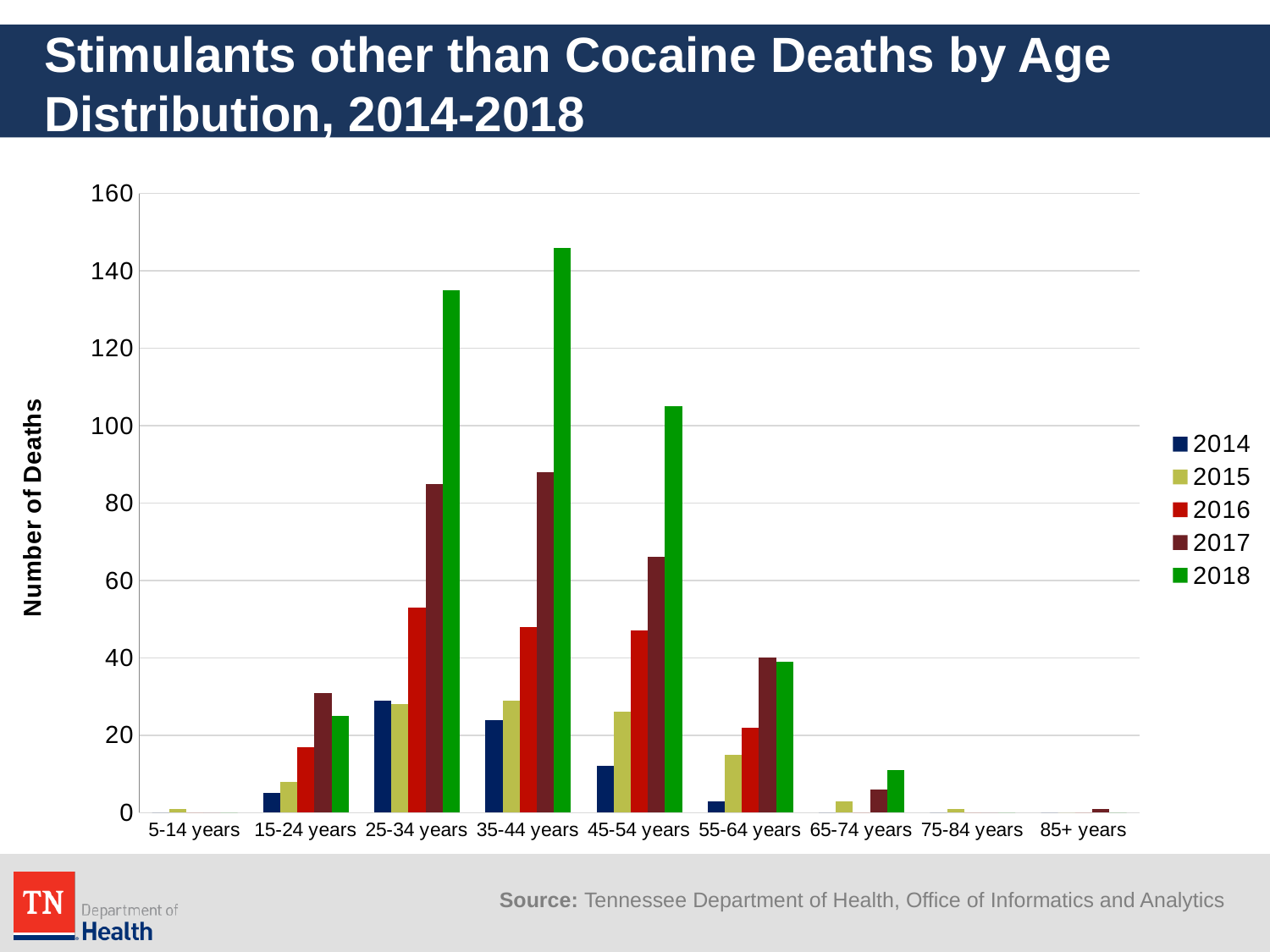
Is the 2018 value for 35-44 years greater or less than 140? greater Is the 2016 value for 25-34 years greater or less than 60? less How many series does the legend list? 5 What is the title of the y axis? Number of Deaths Is the 2018 value for 25-34 years greater or less than 120? greater For the 55-64 years age group, which is larger: the 2015 value or the 2016 value? 2016 For the 45-54 years age group, which is larger: the 2016 value or the 2017 value? 2017 How many age groups are shown on the x axis? 9 For the 25-34 years age group, which year has the highest number of deaths? 2018 Which age group has the highest number of deaths for 2018? 35-44 years What kind of chart is shown on the slide? Bar chart